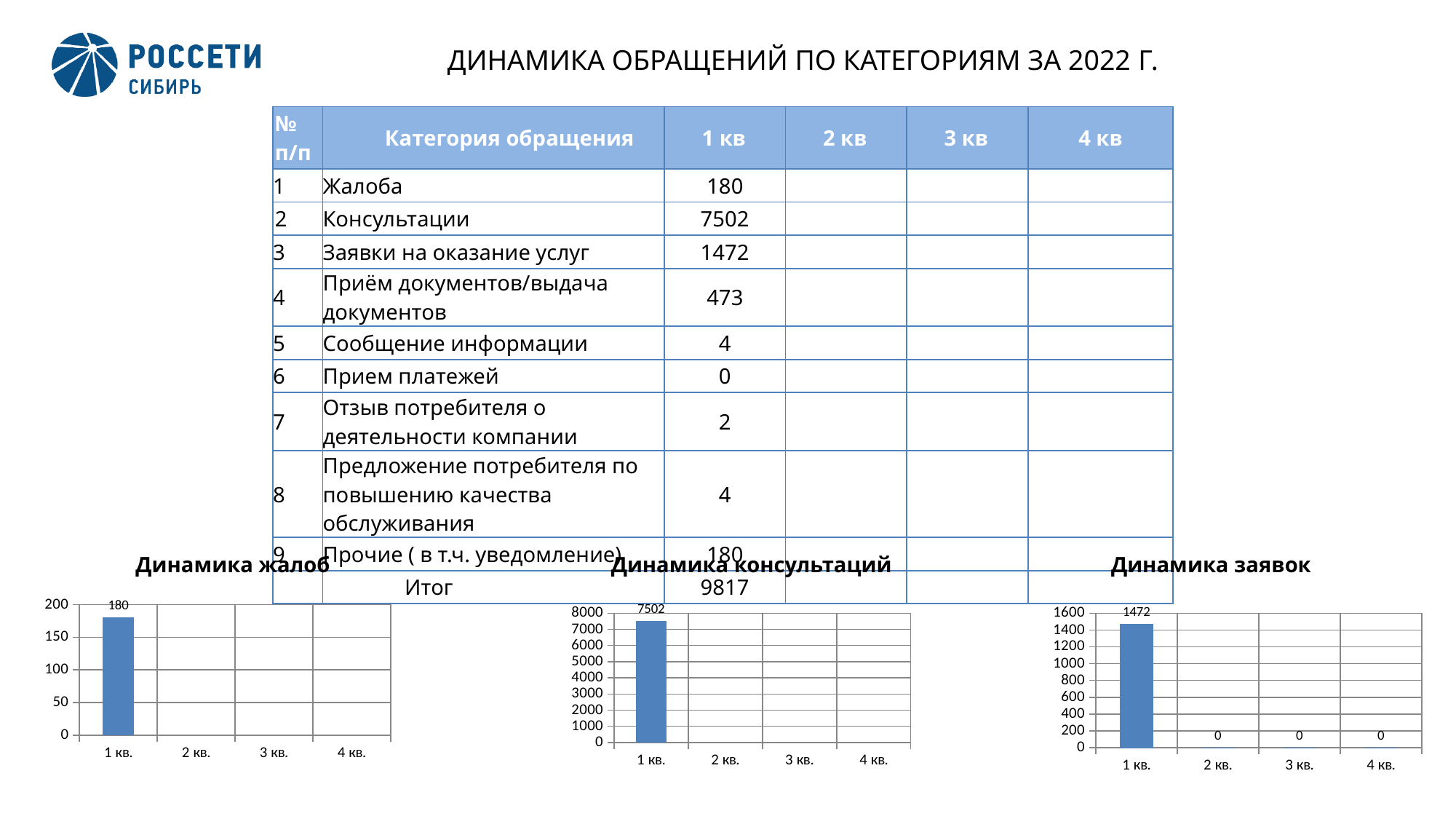
In the chart titled "Динамика заявок", what is the difference between the values for 1 кв. and 2 кв.? 1472 In the chart titled "Динамика жалоб", what is the value for 1 кв.? 180 In the chart titled "Динамика заявок", which quarter has the highest value? 1 кв. In the chart titled "Динамика жалоб", is the value for 1 кв. greater or less than 150? greater How many charts are shown on the slide? 3 What is the title of the chart on the right side of the slide? Динамика заявок How many categories are shown on the x axis of the chart titled "Динамика жалоб"? 4 In the chart titled "Динамика заявок", what is the value for 1 кв.? 1472 In the chart titled "Динамика заявок", what is the value for 3 кв.? 0 What kind of chart is the chart titled "Динамика консультаций"? bar chart In the chart titled "Динамика консультаций", is the value for 1 кв. greater or less than 7000? greater In the chart titled "Динамика консультаций", what is the value for 1 кв.? 7502